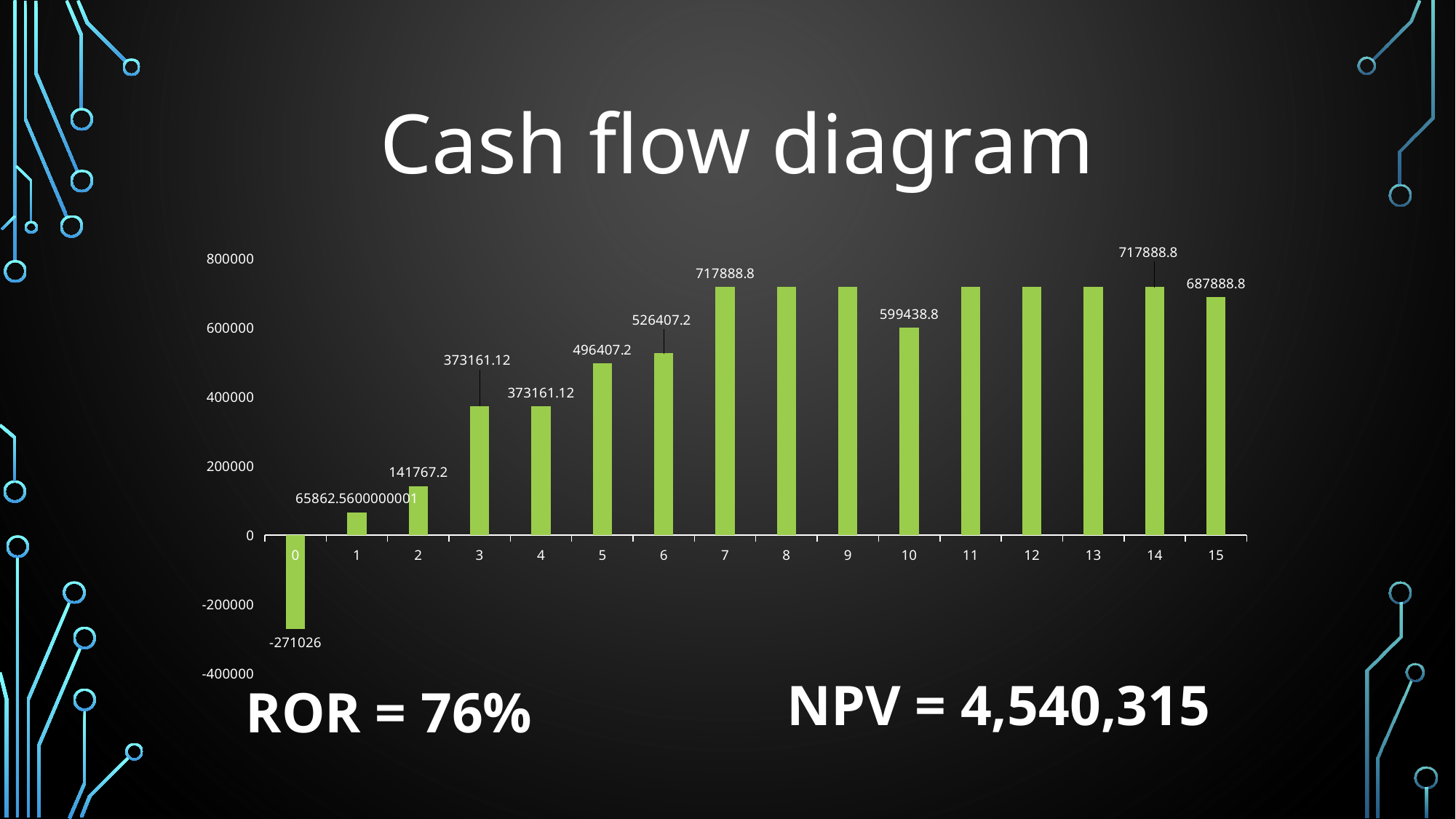
What is the value for year 10 in the cash flow diagram? 599438.8 What is the value for year 2 in the cash flow diagram? 141767.2 Which is larger, the value for year 3 or the value for year 10? year 10 What is the difference between the values for year 14 and year 15? 30000 What is the value for year 0 in the cash flow diagram? -271026 Is the value for year 8 greater or less than 600000? greater What is the value for year 15 in the cash flow diagram? 687888.8 What is the difference between the values for year 6 and year 5? 30000 Which year has the lowest value in the cash flow diagram? 0 How many bars are plotted in the cash flow diagram? 16 What kind of chart is shown on the slide? bar chart What is the value for year 5 in the cash flow diagram? 496407.2